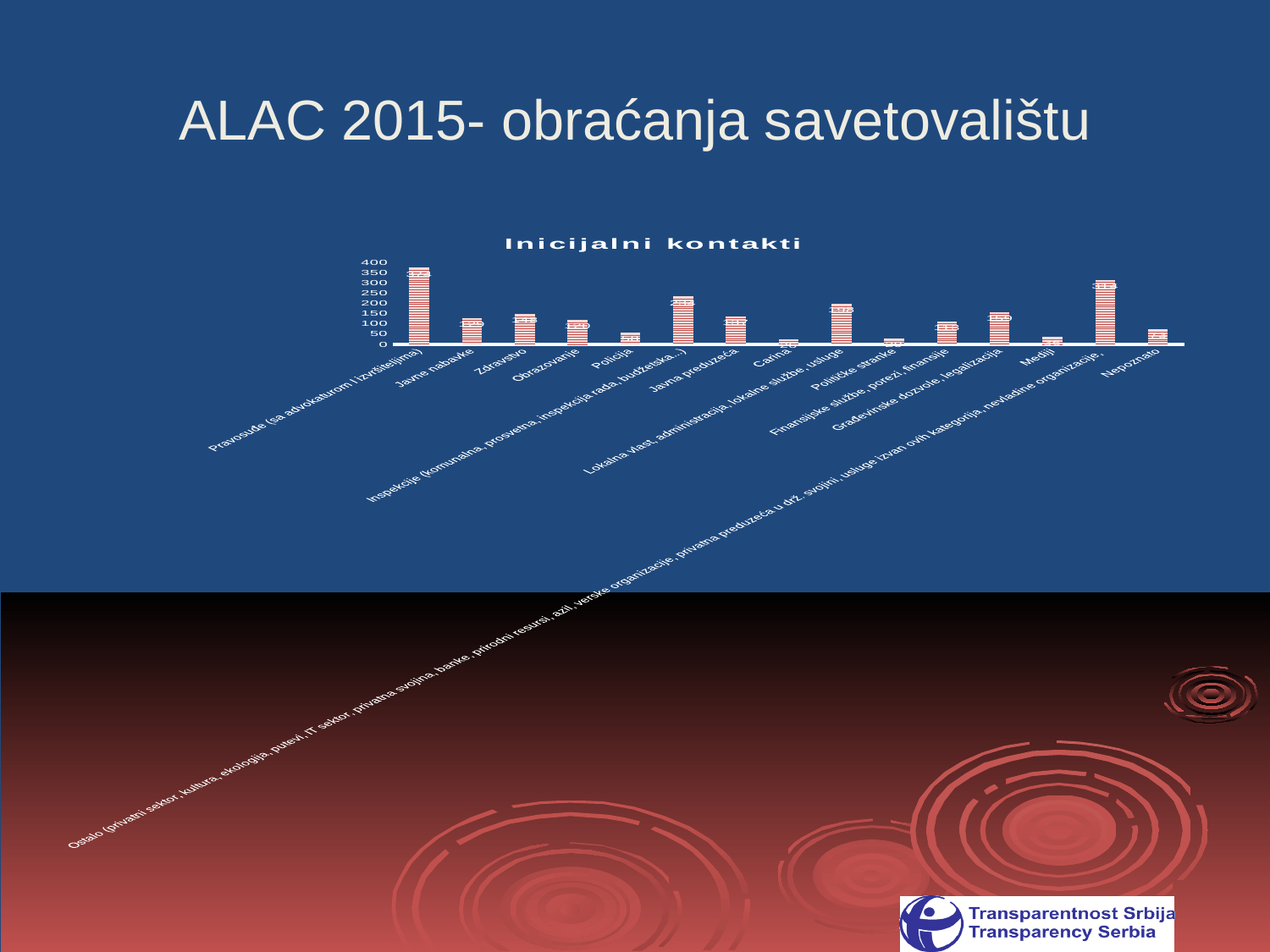
Is the value for Mediji greater or less than 50? less Which is larger, the value for Inspekcije (komunalna, prosvetna, inspekcija rada, budžetska...) or the value for Lokalna vlast, administracija, lokalne službe, usluge? Inspekcije (komunalna, prosvetna, inspekcija rada, budžetska...) Is the value for Pravosuđe (sa advokaturom i izvršiteljima) greater or less than 300? greater What kind of chart is shown on the slide? bar chart Is the value for Inspekcije (komunalna, prosvetna, inspekcija rada, budžetska...) greater or less than 200? greater How many categories are plotted on the x axis of the chart? 15 What is the title of the chart on the slide? Inicijalni kontakti Which category has the highest value in the chart? Pravosuđe (sa advokaturom i izvršiteljima) What is the highest value shown on the y axis of the chart? 400 Which is larger, the value for Carina or the value for Javna preduzeća? Javna preduzeća